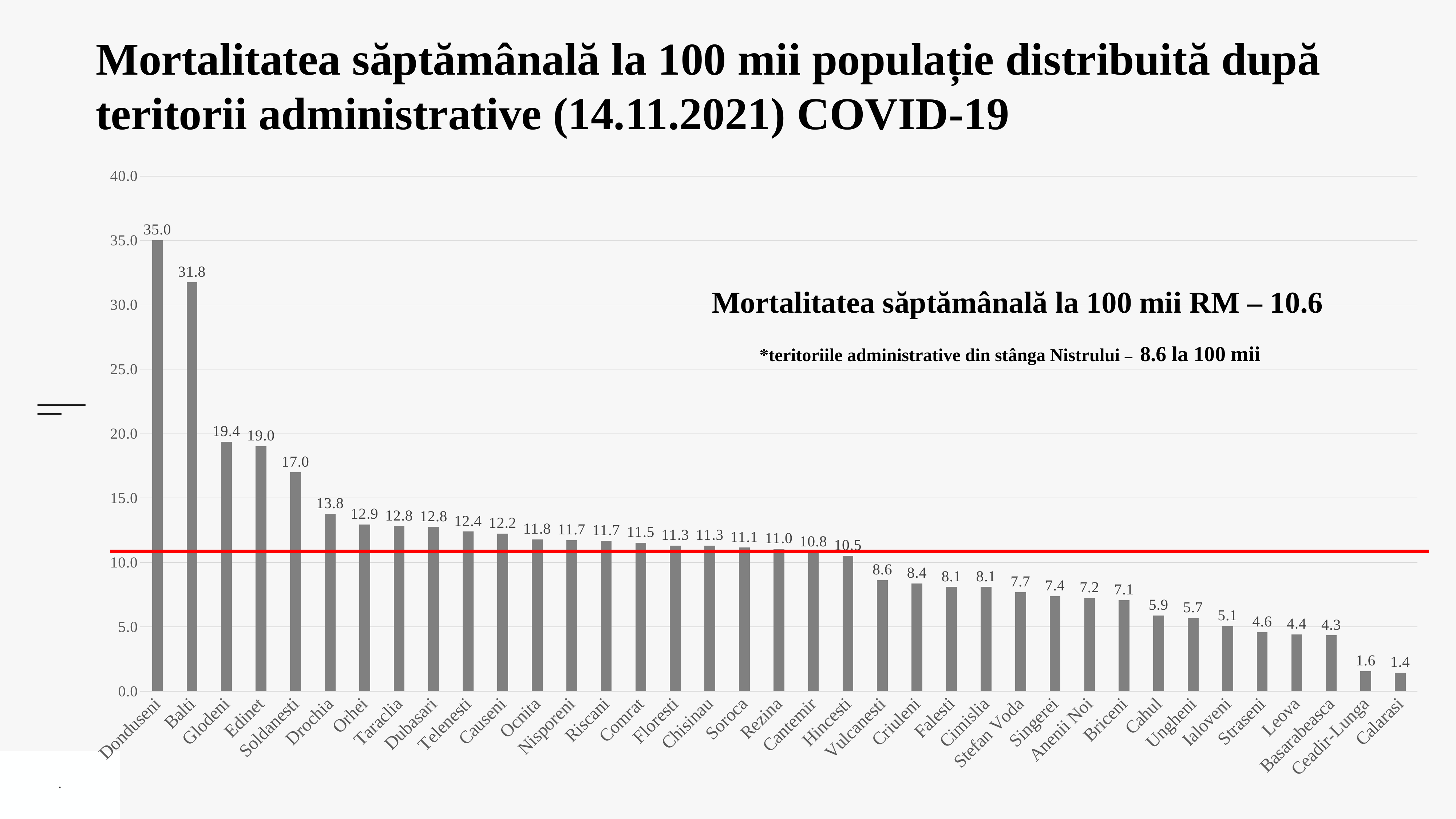
Is the value for Hincesti greater or less than 15.0? less What is the value for Cahul? 5.9 What kind of chart is shown on the slide? bar chart What is the difference between the values for Glodeni and Edinet? 0.4 What is the value for Donduseni? 35.0 Do the values rise or fall from left to right along the x axis? fall Which territory has the highest value? Donduseni What is the difference between the values for Donduseni and Balti? 3.2 How many territories are shown on the x axis? 37 Which territory has the lowest value? Calarasi Which is larger, the value for Soldanesti or the value for Drochia? Soldanesti What is the value for Chisinau? 11.3